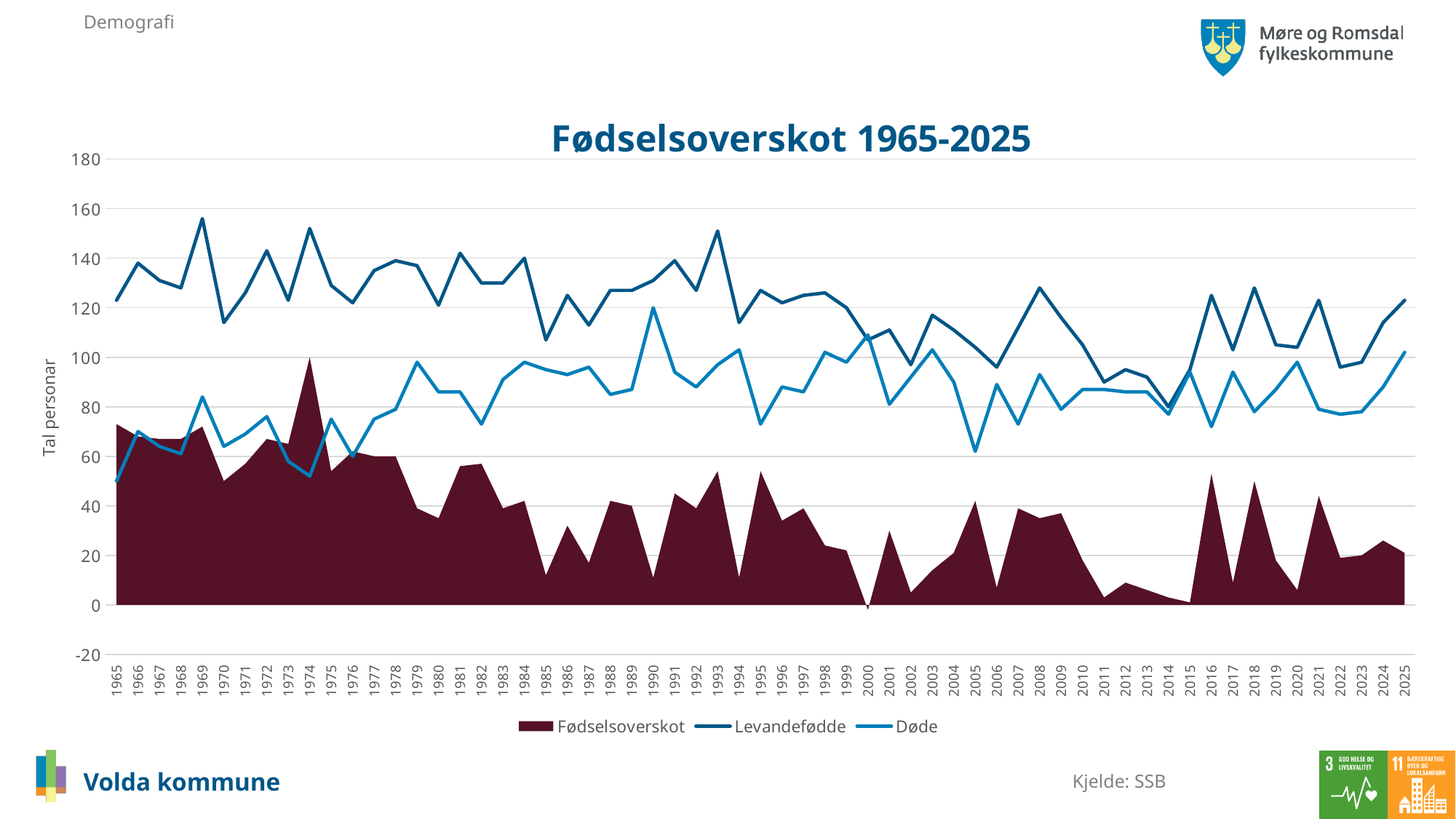
Is the value for Døde in 2005 greater or less than 80? less How many series does the legend list? 3 In which year is the Levandefødde series at its lowest? 2014 Is the value for Levandefødde in 1969 greater or less than 140? greater In which year is the Døde series at its lowest? 1965 What is the label on the vertical axis? Tal personar How many years are plotted along the x axis? 61 In 1965, which is larger: Levandefødde or Døde? Levandefødde In which year does the Døde series reach its highest value? 1990 In which year does the Fødselsoverskot series reach its highest value? 1974 Does the Fødselsoverskot series generally rise or fall from 1965 to 2025? fall What is the title of the chart? Fødselsoverskot 1965-2025